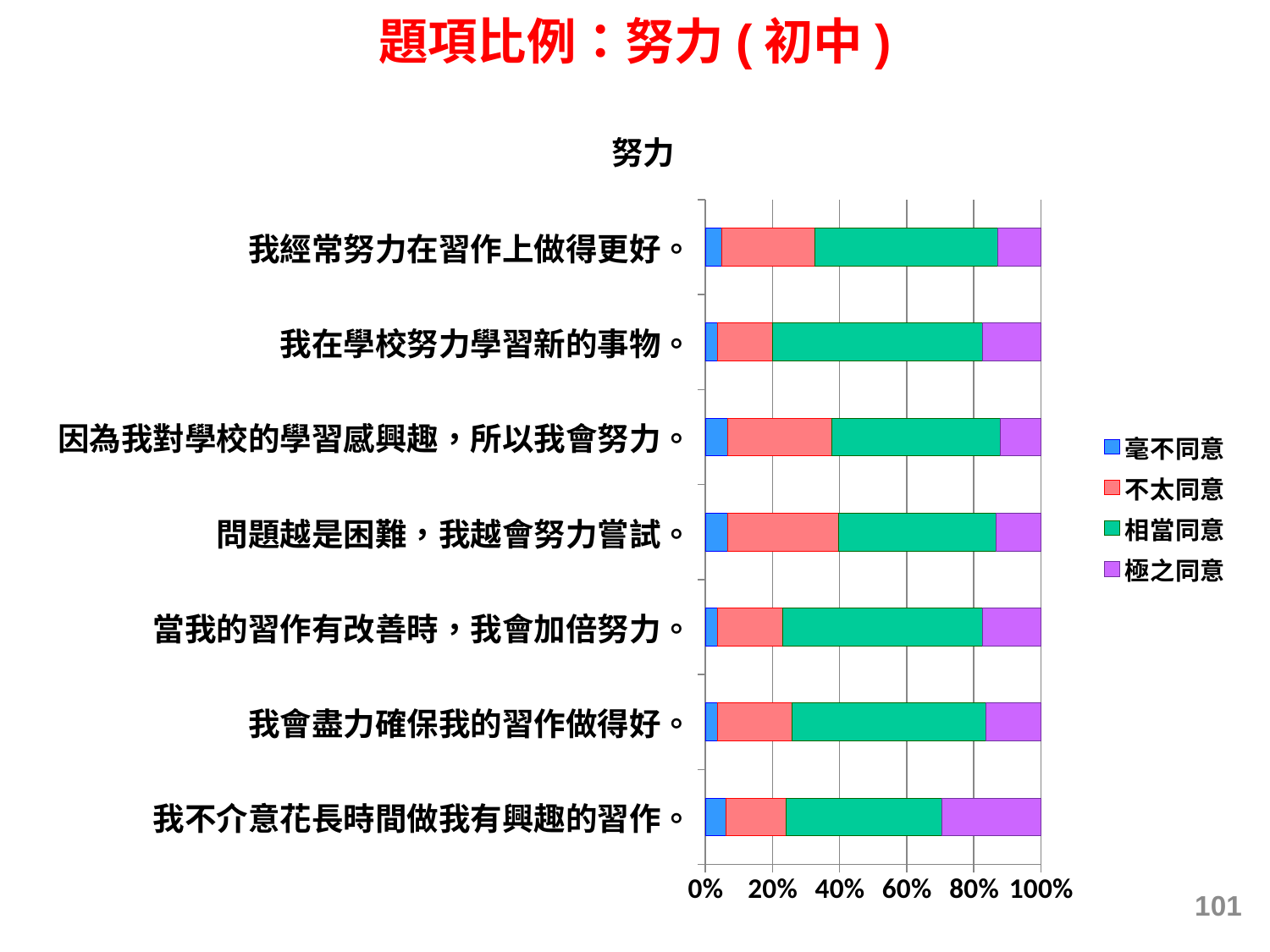
How many series does the legend list? 4 Is the 不太同意 share for 問題越是困難，我越會努力嘗試。 greater or less than 20%? greater What kind of chart is shown on the slide? Stacked bar chart Is the 極之同意 share for 我不介意花長時間做我有興趣的習作。 greater or less than 20%? greater Which legend entry is shown in purple? 極之同意 What does each full stacked bar total on the x axis? 100% Which has the larger 極之同意 share: 我不介意花長時間做我有興趣的習作。 or 我經常努力在習作上做得更好。? 我不介意花長時間做我有興趣的習作。 Which has the larger 不太同意 share: 問題越是困難，我越會努力嘗試。 or 我在學校努力學習新的事物。? 問題越是困難，我越會努力嘗試。 Which statement has the largest 極之同意 share? 我不介意花長時間做我有興趣的習作。 Is the 極之同意 share for 我經常努力在習作上做得更好。 greater or less than 20%? less How many statements (categories) are plotted in the chart? 7 What is the title shown above the chart? 努力